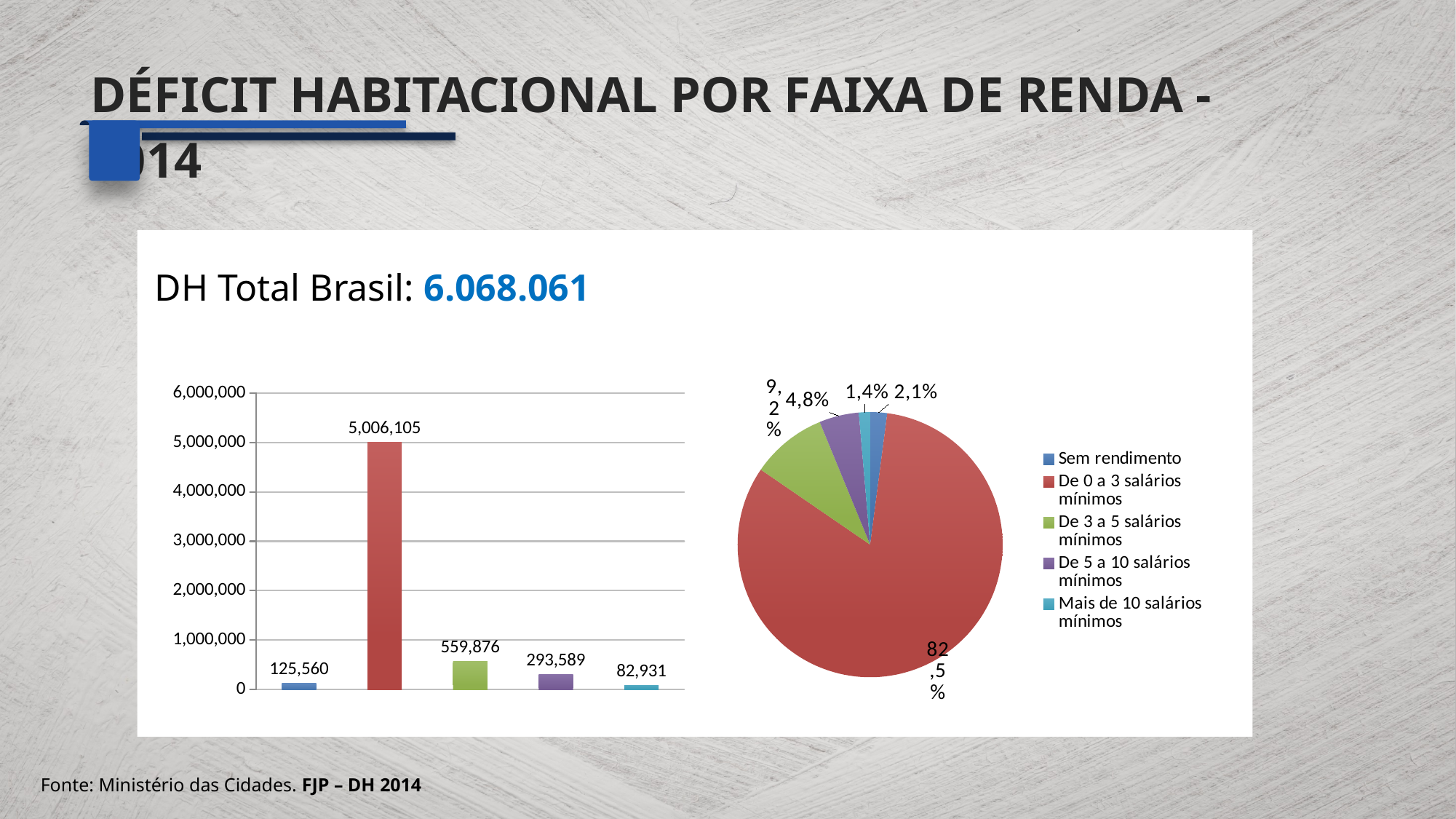
In the bar chart on the left, what is the difference between the third bar (559,876) and the fourth bar (293,589)? 266,287 What kind of chart is the chart on the left of the slide? Bar chart In the bar chart on the left, what is the value of the shortest bar? 82,931 In the pie chart on the right, which category has the largest share? De 0 a 3 salários mínimos In the pie chart on the right, what share does 'De 0 a 3 salários mínimos' have? 82,5% In the bar chart on the left, what is the value of the third bar (the green one)? 559,876 In the bar chart on the left, what is the value of the tallest bar? 5,006,105 In the bar chart on the left, is the value of the fourth bar (the purple one) greater or less than 1,000,000? less In the bar chart on the left, how many bars are plotted? 5 In the pie chart on the right, what share does 'De 3 a 5 salários mínimos' have? 9,2% In the pie chart on the right, how many categories does the legend list? 5 In the bar chart on the left, what is the value of the first (leftmost) bar? 125,560